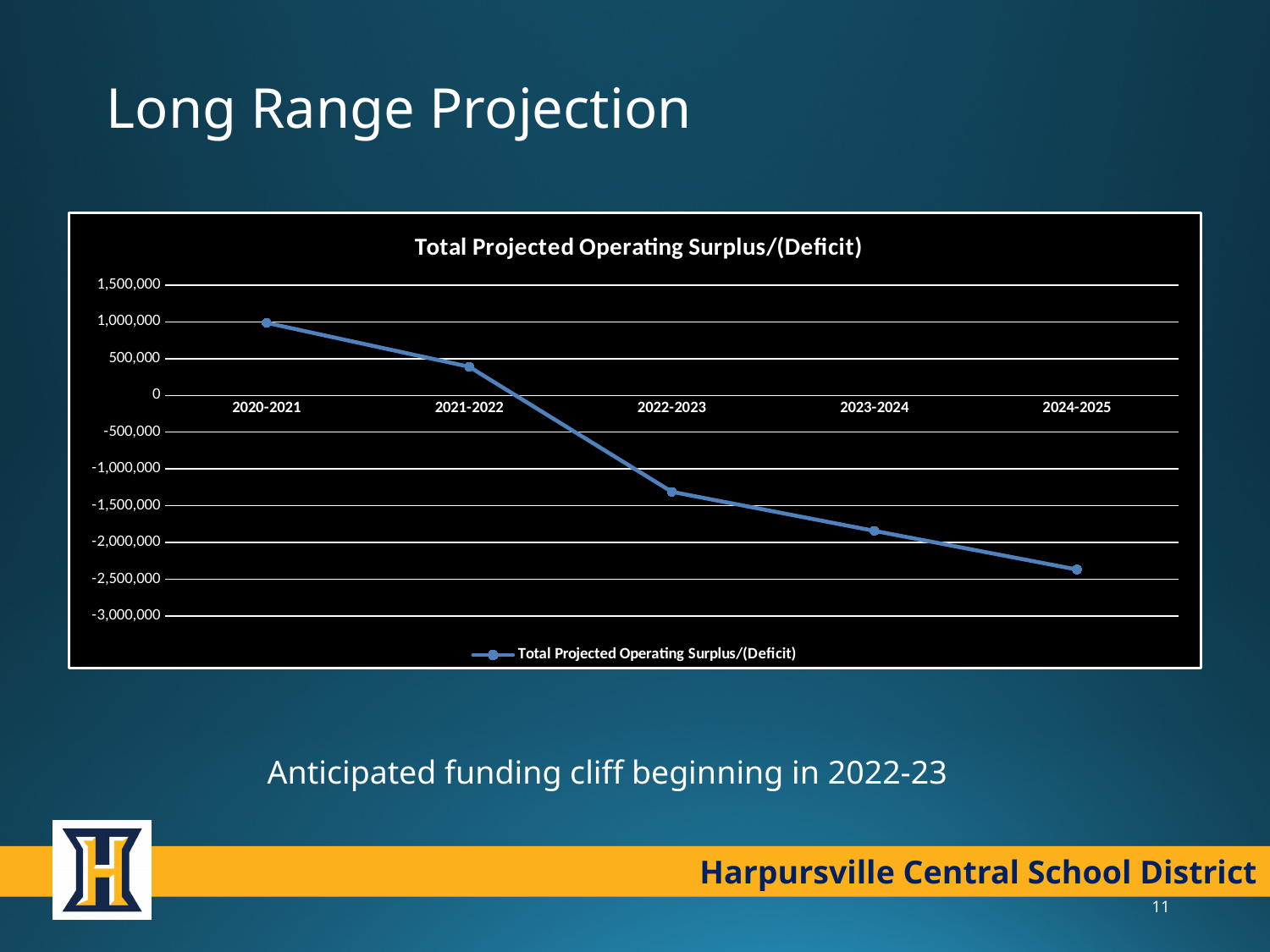
Is the value for 2024-2025 greater or less than -2,000,000? less What kind of chart is shown on the slide? Line chart Is the value for 2022-2023 greater or less than -1,000,000? less Is the value for 2020-2021 greater or less than 500,000? greater Which is larger, the value for 2021-2022 or the value for 2023-2024? 2021-2022 How many school years are plotted on the x axis? 5 Which school year has the lowest projected operating surplus/(deficit)? 2024-2025 What is the title of the chart? Total Projected Operating Surplus/(Deficit) Do the values rise or fall from 2020-2021 to 2024-2025? Fall Which school year has the highest projected operating surplus/(deficit)? 2020-2021 How many series does the legend list? 1